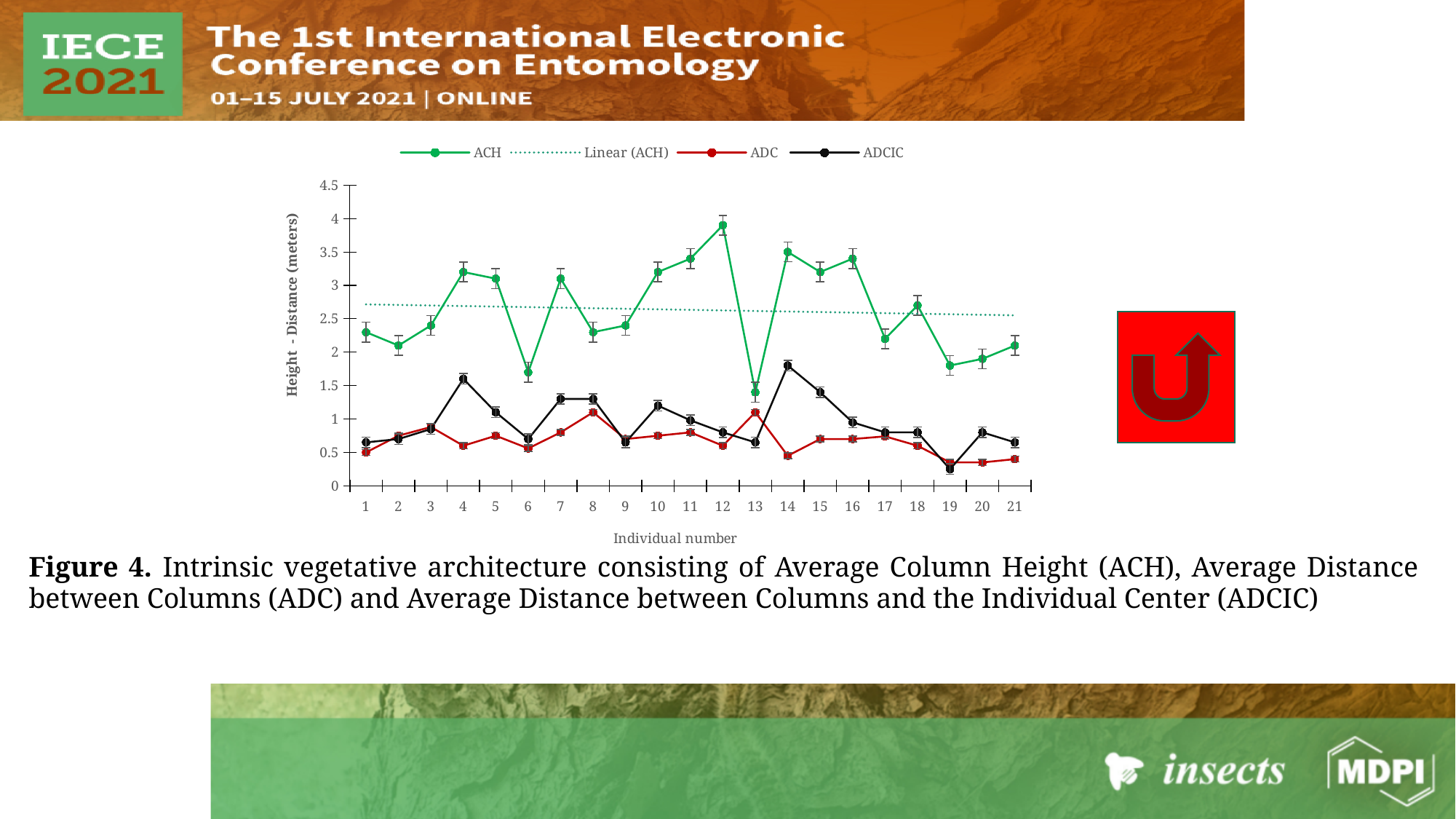
What is the title of the x axis? Individual number For which individual number is the ACH value lowest? 13 How many entries does the chart legend list? 4 What kind of chart is shown on the slide? Line chart For which individual number is the ACH value highest? 12 Which is larger for individual 4: the ADCIC value or the ADC value? ADCIC Is the ACH value for individual 6 greater or less than 2? less For which individual number is the ADCIC value highest? 14 Is the ACH value for individual 12 greater or less than 3.5? greater How many individuals are plotted along the x axis? 21 Is the ADCIC value for individual 14 greater or less than 1.5? greater For which individual number is the ADCIC value lowest? 19